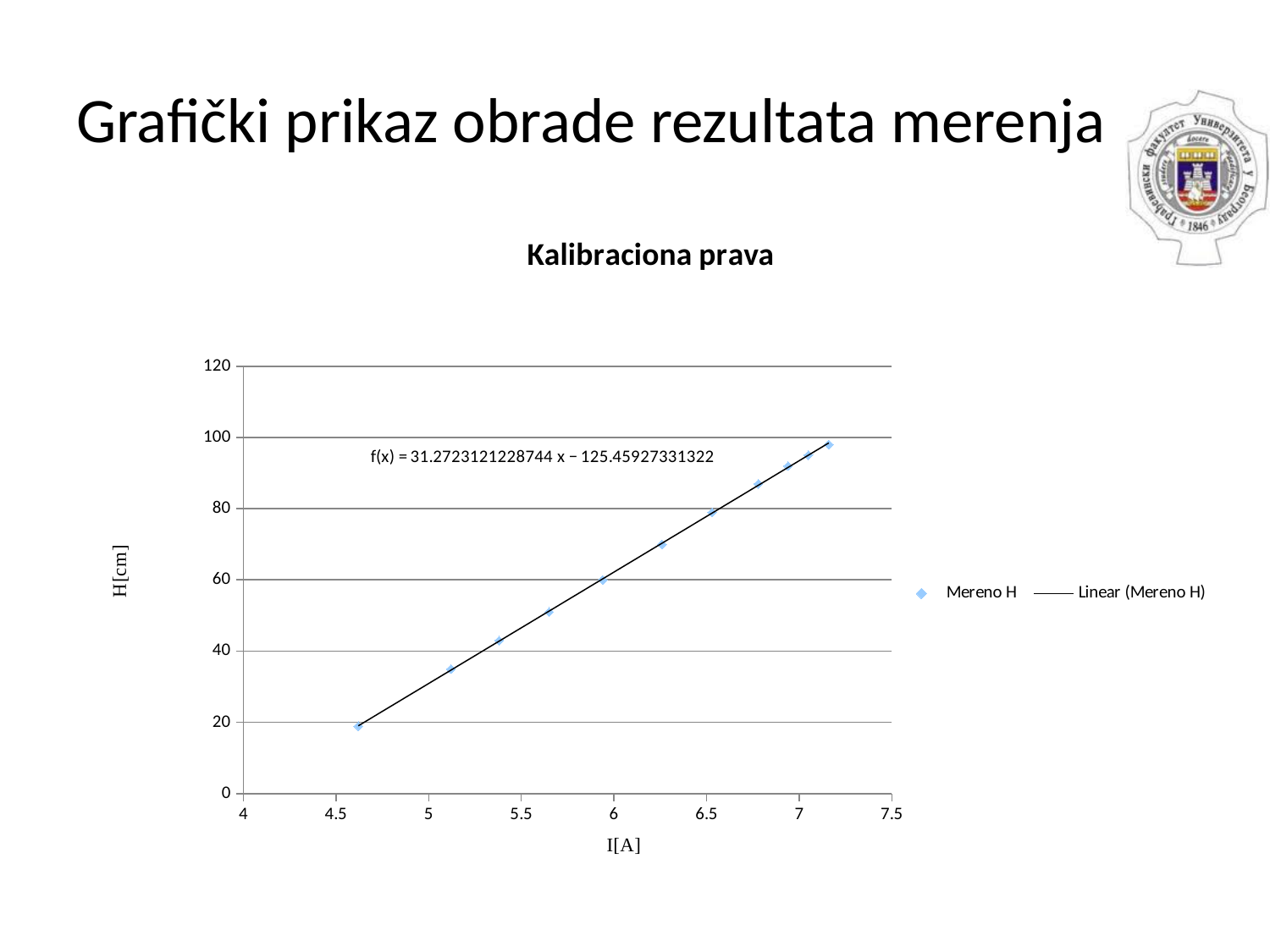
What are the labels of the x axis and the y axis of the chart? I[A] and H[cm] What kind of chart is shown on the slide? Scatter chart with a linear trendline What is the trendline equation printed on the chart? f(x) = 31.2723121228744 x − 125.45927331322 Is the H[cm] value of the Mereno H point near I = 6.8 A greater or less than 80? greater Which Mereno H point has the highest H[cm] value, the leftmost or the rightmost? The rightmost What is the title of the chart? Kalibraciona prava Do the Mereno H values rise or fall as I[A] increases? Rise What is the slope of the linear trendline shown on the chart? 31.2723121228744 What is the intercept of the linear trendline shown on the chart? −125.45927331322 Is the H[cm] value of the rightmost Mereno H point greater or less than 80? greater How many entries does the chart legend list? 2 Is the H[cm] value of the leftmost Mereno H point greater or less than 40? less